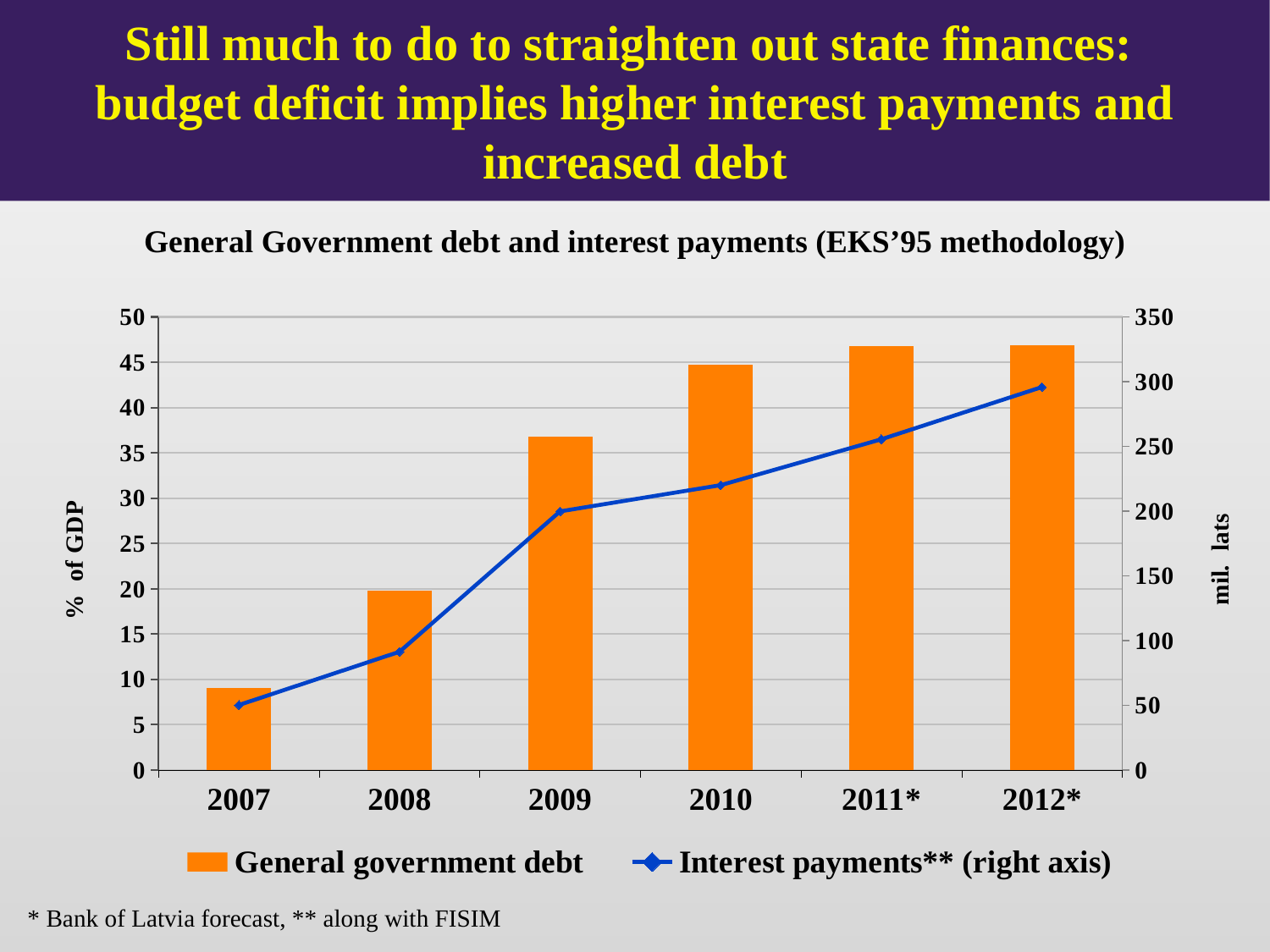
How many years are shown on the x axis of the chart? 6 Which year has the larger general government debt bar, 2009 or 2010? 2010 Do the interest payments rise or fall from 2007 to 2012*? rise Is the interest payments value for 2012* greater or less than 250 mil. lats? greater How many series does the chart legend list? 2 Is the general government debt bar for 2009 greater or less than 35% of GDP? greater What kind of chart is shown on the slide? A combined bar and line chart Is the interest payments value for 2008 greater or less than 100 mil. lats? less Which year has the lowest general government debt bar? 2007 What is the label of the right-hand vertical axis? mil. lats